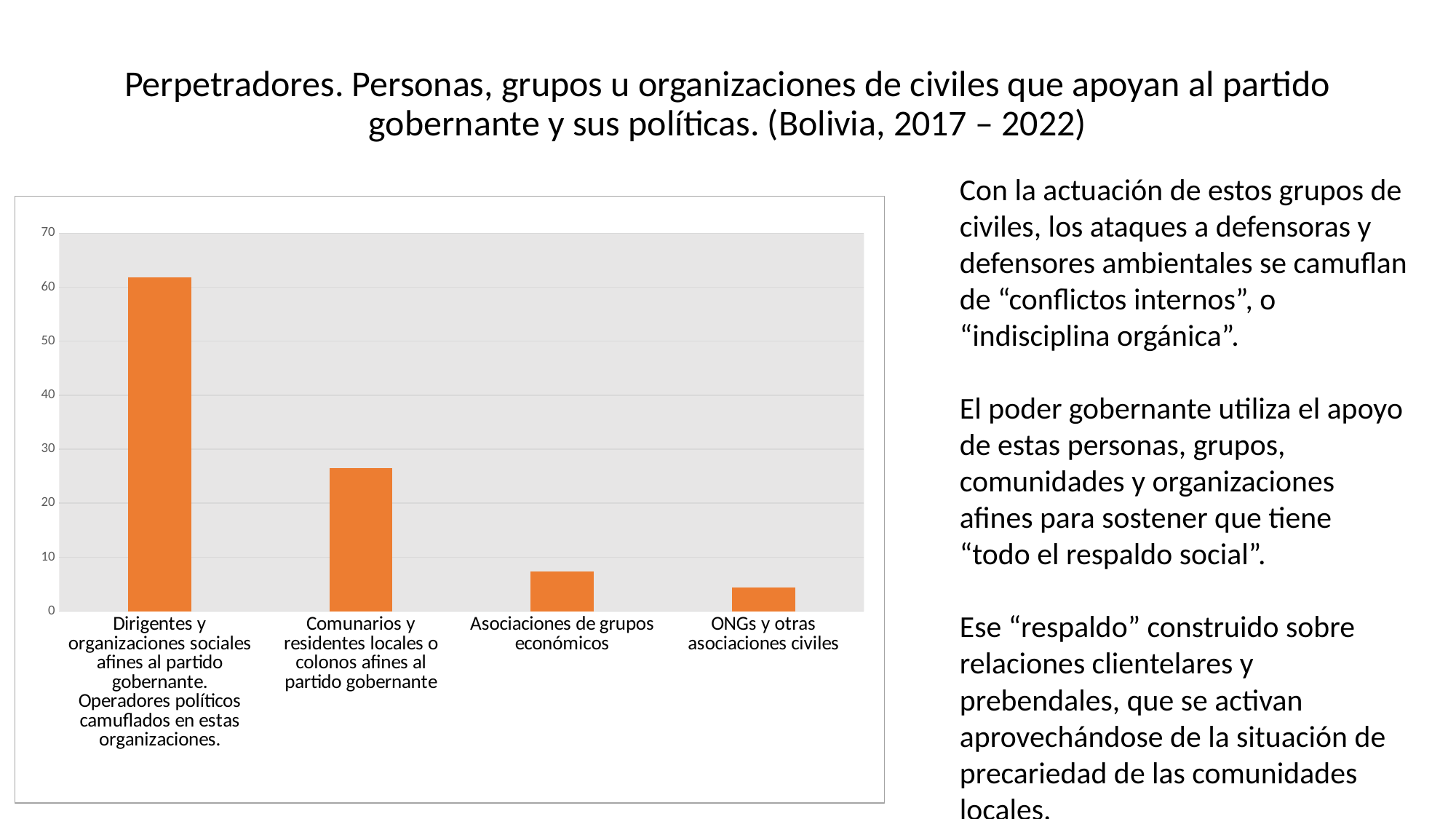
Which category has the lowest value in the chart? ONGs y otras asociaciones civiles Which category has the highest value in the chart? Dirigentes y organizaciones sociales afines al partido gobernante. Operadores políticos camuflados en estas organizaciones. What kind of chart is shown on the slide? bar chart Which is larger: the value for 'Comunarios y residentes locales o colonos afines al partido gobernante' or the value for 'Asociaciones de grupos económicos'? Comunarios y residentes locales o colonos afines al partido gobernante Is the value for 'Asociaciones de grupos económicos' greater or less than 10? less What colour are the bars in the chart? orange Is the value for 'Dirigentes y organizaciones sociales afines al partido gobernante' greater or less than 60? greater What is the highest value shown on the vertical axis of the chart? 70 Do the bar values rise or fall from left to right across the categories? fall Is the value for 'Comunarios y residentes locales o colonos afines al partido gobernante' greater or less than 30? less How many categories are plotted in the chart? 4